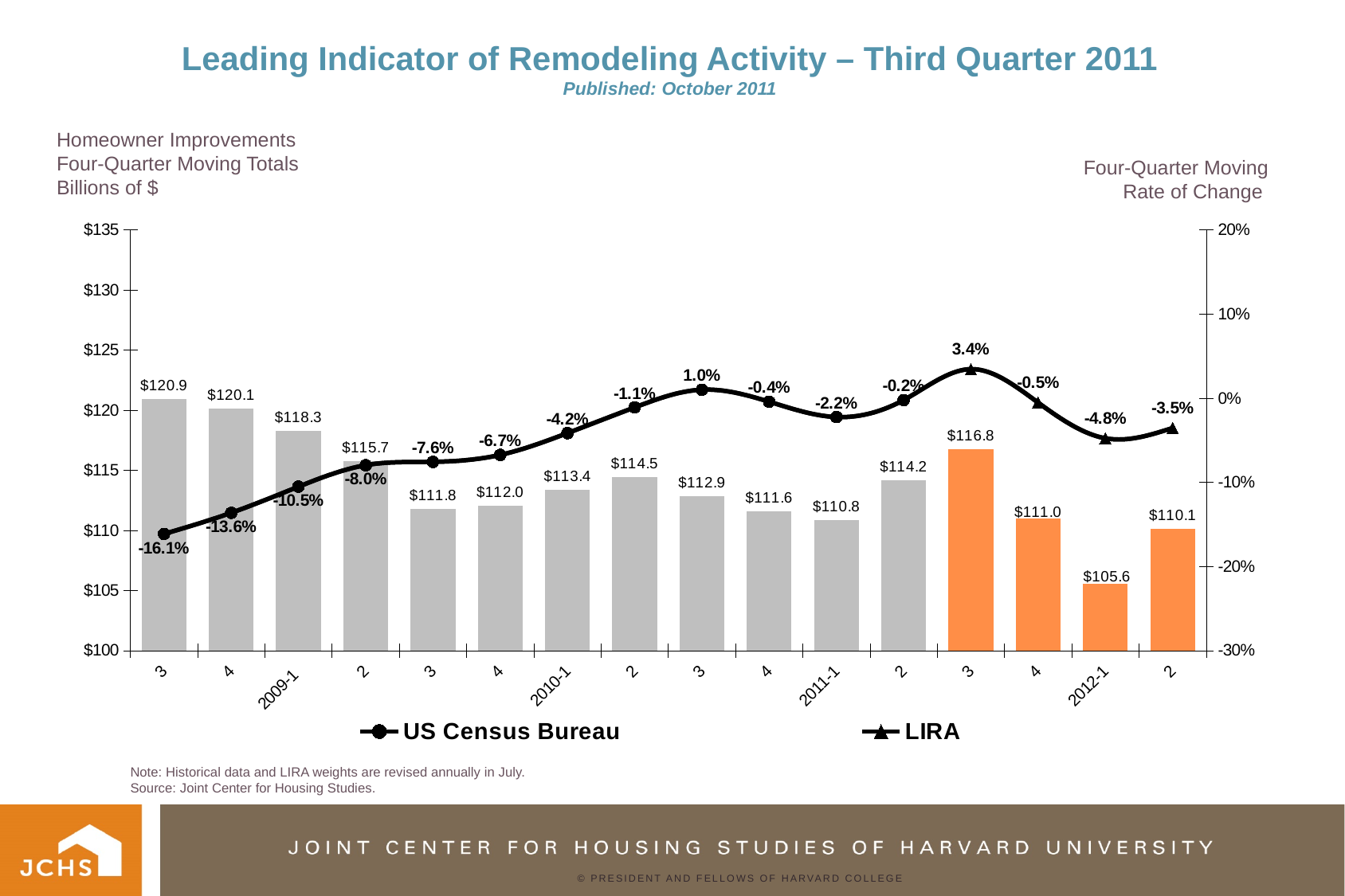
How many bars are plotted on the chart? 16 What is the value of the bar for 2012-1? $105.6 What is the value of the highest bar on the chart? $120.9 Which has a larger bar value, 2010-1 or 2011-1? 2010-1 What is the four-quarter moving rate of change shown for 2010-1? -4.2% What is the value of the bar for 2009-1? $118.3 How many series does the legend list? 2 What is the highest rate of change value labeled on the line? 3.4% What is the difference between the bar values for 2011-1 and 2012-1? $5.2 What is the lowest rate of change value labeled on the line? -16.1% What kind of chart is shown on the slide? Combination bar and line chart Which category has the lowest bar value? 2012-1